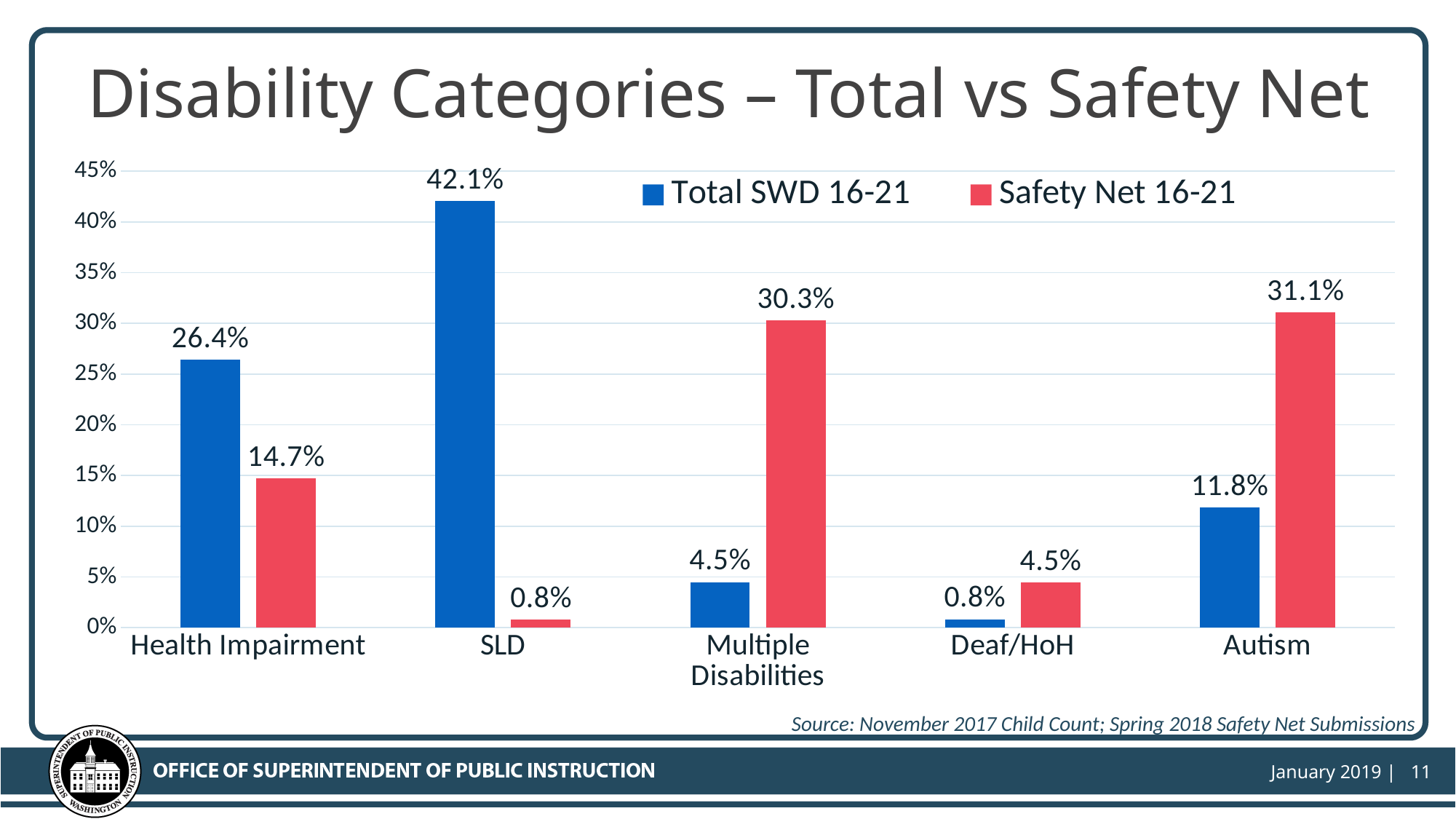
What colour represents the Safety Net 16-21 series? Red How many disability categories are shown on the x axis? 5 What is the Total SWD 16-21 value for SLD? 42.1% What is the Safety Net 16-21 value for Multiple Disabilities? 30.3% What is the difference between the Total SWD 16-21 and Safety Net 16-21 values for Autism? 19.3% Which category has the highest Total SWD 16-21 value? SLD What is the Safety Net 16-21 value for Health Impairment? 14.7% Which category has the lowest Safety Net 16-21 value? SLD What kind of chart is shown on the slide? Bar chart What is the difference between the Total SWD 16-21 values for SLD and Health Impairment? 15.7% Which is larger for Deaf/HoH: the Total SWD 16-21 value or the Safety Net 16-21 value? Safety Net 16-21 How many series does the legend list? 2